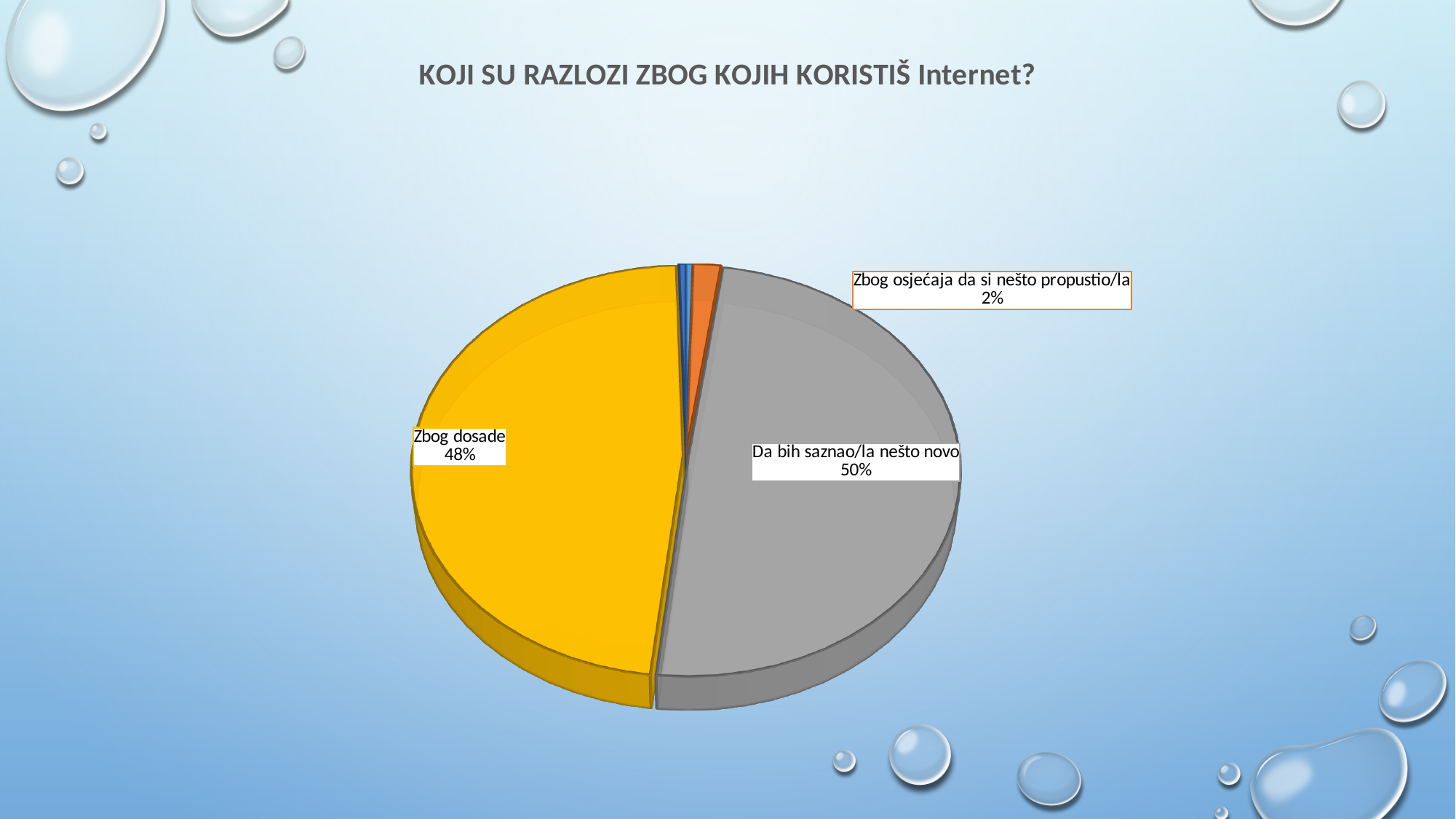
Which labelled slice has the smallest share of the pie? Zbog osjećaja da si nešto propustio/la What is the difference in percentage points between "Da bih saznao/la nešto novo" and "Zbog dosade"? 2 Which is larger, the share for "Zbog dosade" or the share for "Zbog osjećaja da si nešto propustio/la"? Zbog dosade What percentage is shown for "Zbog dosade"? 48% What kind of chart is shown on the slide? pie chart What is the difference in percentage points between "Zbog dosade" and "Zbog osjećaja da si nešto propustio/la"? 46 What percentage is shown for "Da bih saznao/la nešto novo"? 50% What percentage is shown for "Zbog osjećaja da si nešto propustio/la"? 2% What colour is the slice for "Zbog dosade"? yellow How many slices of the pie have a printed label with a percentage? 3 What is the title of the chart on the slide? KOJI SU RAZLOZI ZBOG KOJIH KORISTIŠ Internet? Which labelled slice has the largest share of the pie? Da bih saznao/la nešto novo